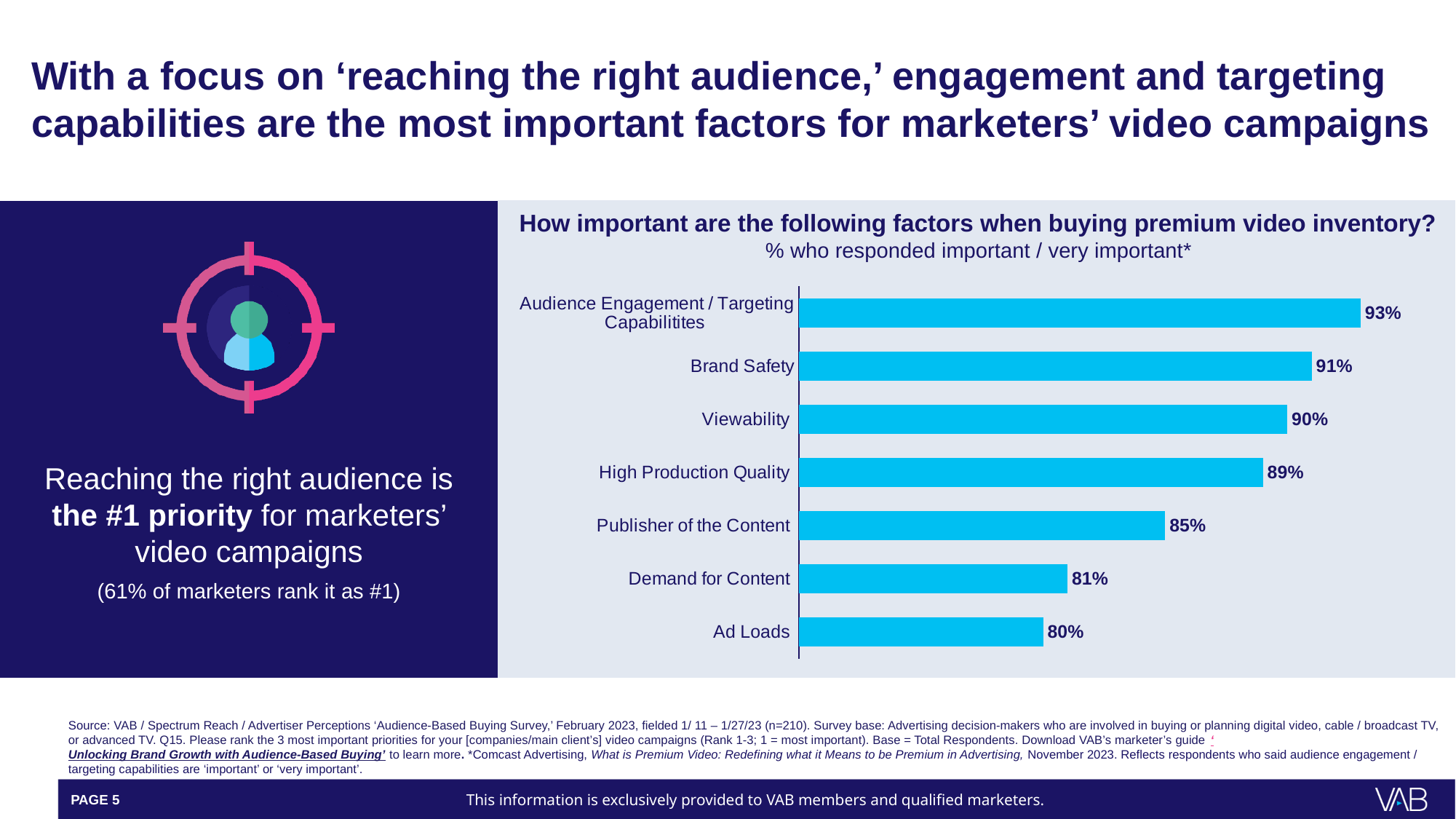
Do the values rise or fall going from the top bar to the bottom bar? Fall What is the difference in percentage points between Viewability and Demand for Content? 9 What is the value shown for Ad Loads? 80% What percentage is shown for Publisher of the Content? 85% What kind of chart is shown on the slide? Bar chart Which has a higher value, High Production Quality or Publisher of the Content? High Production Quality What is the title of the chart? How important are the following factors when buying premium video inventory? Which factor has the highest percentage in the chart? Audience Engagement / Targeting Capabilitites Which factor has the lowest percentage in the chart? Ad Loads How many factors are shown in the chart? 7 What percentage of respondents rated Brand Safety as important / very important? 91% What is the difference in percentage points between Audience Engagement / Targeting Capabilitites and Ad Loads? 13